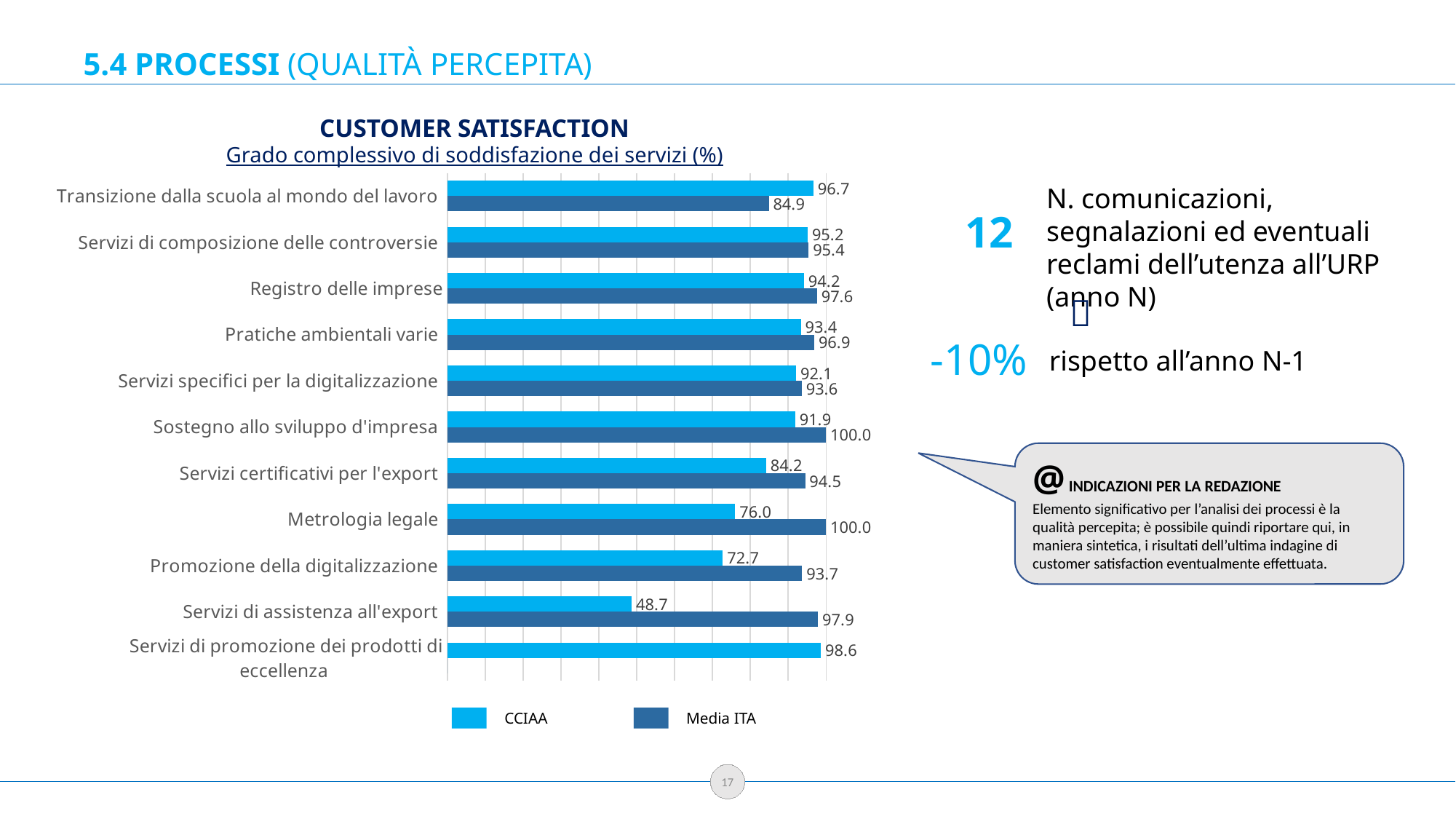
What is the difference between the Media ITA and CCIAA values for Metrologia legale? 24.0 How many categories are shown on the chart? 11 What is the CCIAA value for Metrologia legale? 76.0 Which category has the highest CCIAA value? Servizi di promozione dei prodotti di eccellenza What are the two series named in the chart legend? CCIAA and Media ITA What is the CCIAA value for Transizione dalla scuola al mondo del lavoro? 96.7 What is the difference between the CCIAA and Media ITA values for Transizione dalla scuola al mondo del lavoro? 11.8 For Servizi certificativi per l'export, which is larger: the CCIAA value or the Media ITA value? Media ITA How many series does the legend list? 2 What is the Media ITA value for Servizi di assistenza all'export? 97.9 What kind of chart is shown on the slide? Bar chart Which category has the lowest CCIAA value? Servizi di assistenza all'export